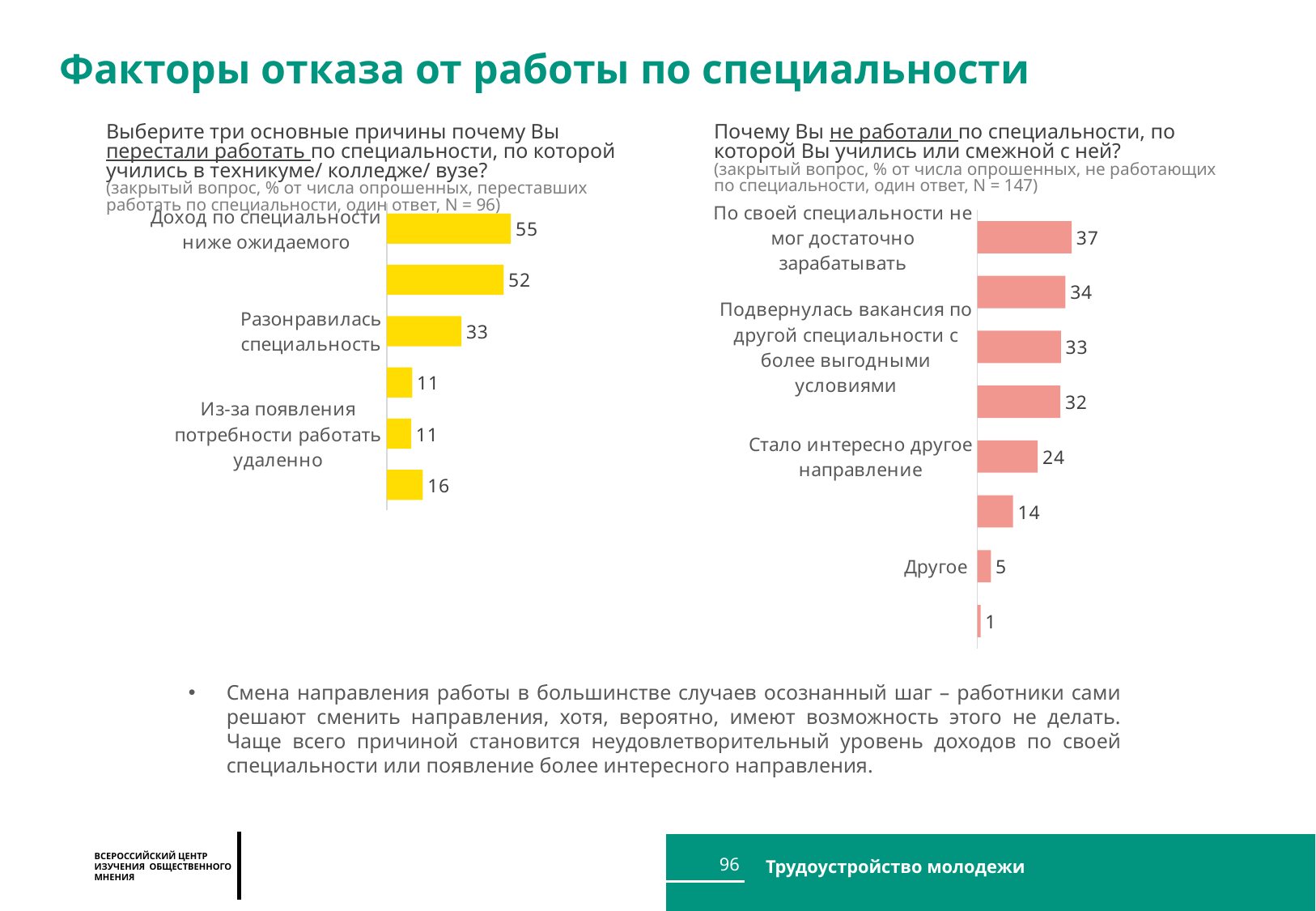
On the left chart, what is the value for 'Из-за появления потребности работать удаленно'? 11 On the left chart, how many bars are plotted? 6 What type of chart is used on the left side of the slide? Bar chart On the right chart, what is the value for 'Другое'? 5 On the right chart, how many bars are plotted? 8 On the left chart, what is the value for 'Разонравилась специальность'? 33 On the left chart, what is the highest value shown? 55 On the right chart, what is the lowest value shown? 1 On the right chart, what is the value for 'Стало интересно другое направление'? 24 On the right chart, what is the value for 'По своей специальности не мог достаточно зарабатывать'? 37 On the left chart, what is the value for 'Доход по специальности ниже ожидаемого'? 55 On the right chart, what is the difference between 'По своей специальности не мог достаточно зарабатывать' and 'Стало интересно другое направление'? 13